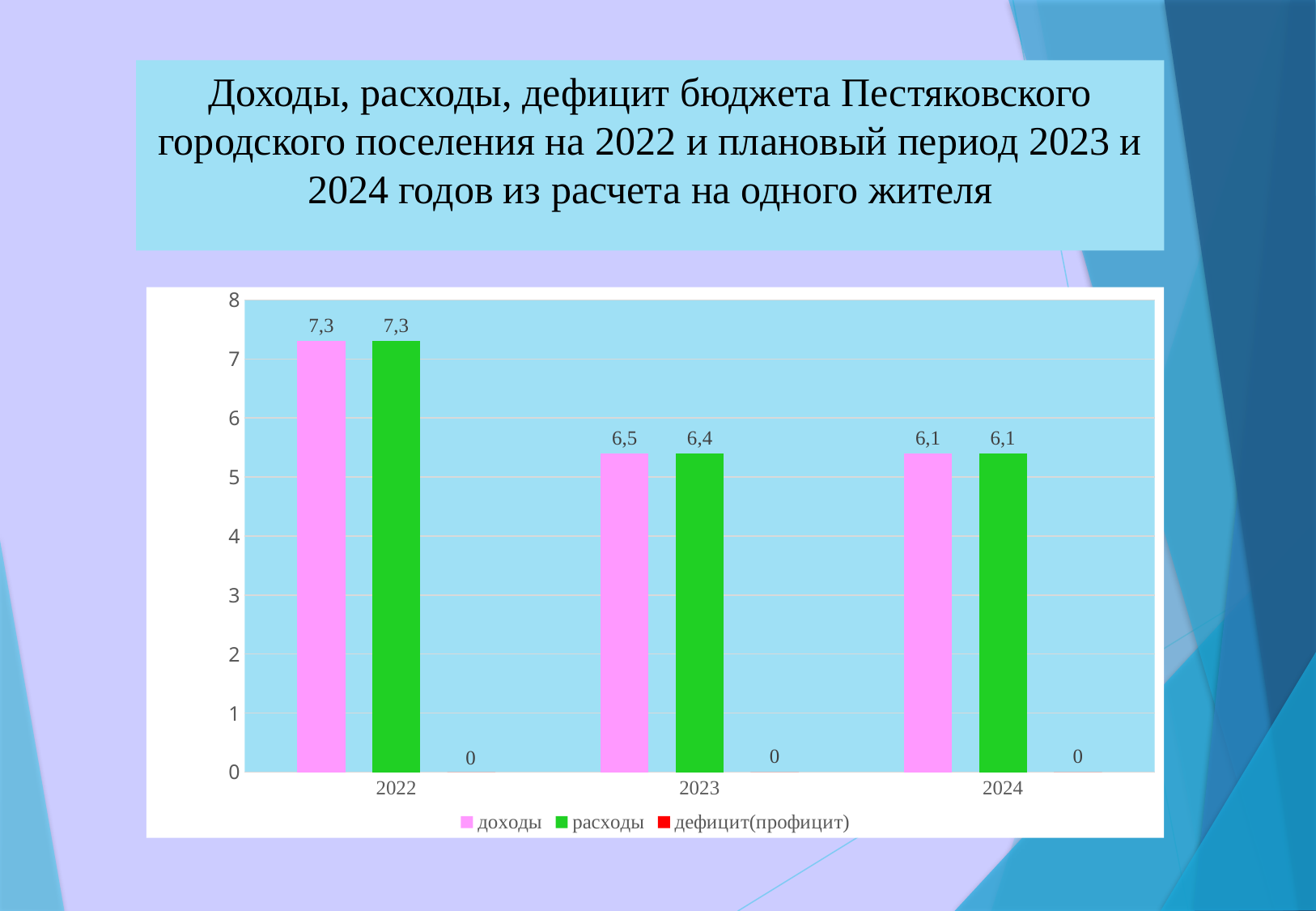
In which year is расходы the lowest? 2024 What is the difference between доходы in 2022 and доходы in 2024? 1,2 What is the value for дефицит(профицит) in 2023? 0 How many series does the legend list? 3 What kind of chart is shown on the slide? bar chart Which is larger in 2023, доходы or расходы? доходы What is the value for доходы in 2024? 6,1 What is the difference between доходы and расходы in 2023? 0,1 What is the value for расходы in 2023? 6,4 In which year is доходы the highest? 2022 How many years are shown on the x axis? 3 What is the value for доходы in 2022? 7,3